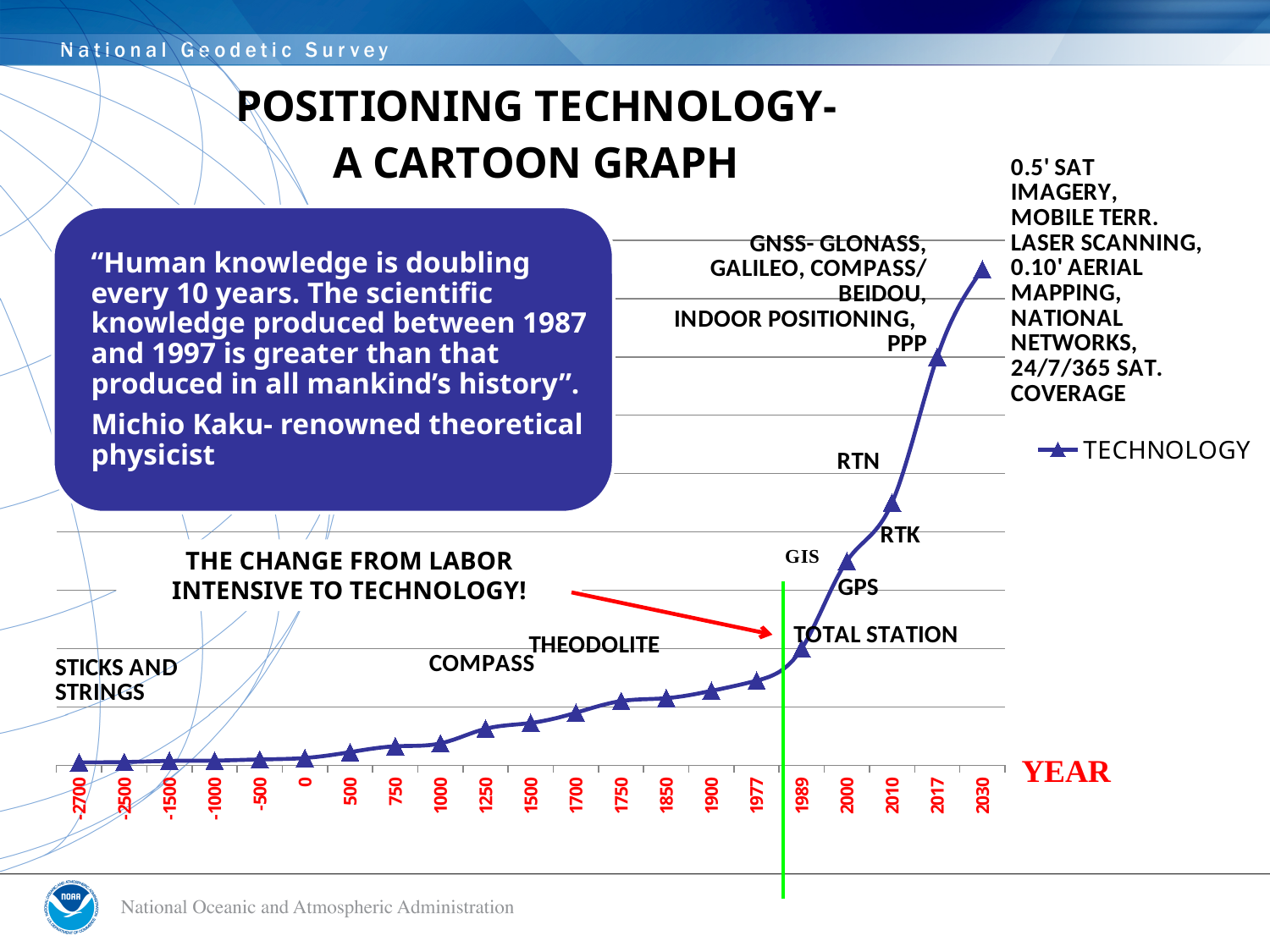
What is the first year label shown on the x axis of the chart? -2700 What is the title of the x axis of the chart? YEAR What is the last year label shown on the x axis of the chart? 2030 Which has the larger TECHNOLOGY value, the year 1989 or the year 2017? 2017 Which year on the x axis has the highest TECHNOLOGY value? 2030 Which has the larger TECHNOLOGY value, the year 1977 or the year 2030? 2030 How many year categories are shown along the x axis of the chart? 21 Which has the larger TECHNOLOGY value, the year 1500 or the year 2000? 2000 How many series does the chart legend list? 1 What kind of chart is shown on the slide? Line chart Do the TECHNOLOGY values generally rise or fall as the years move from -2700 to 2030? Rise